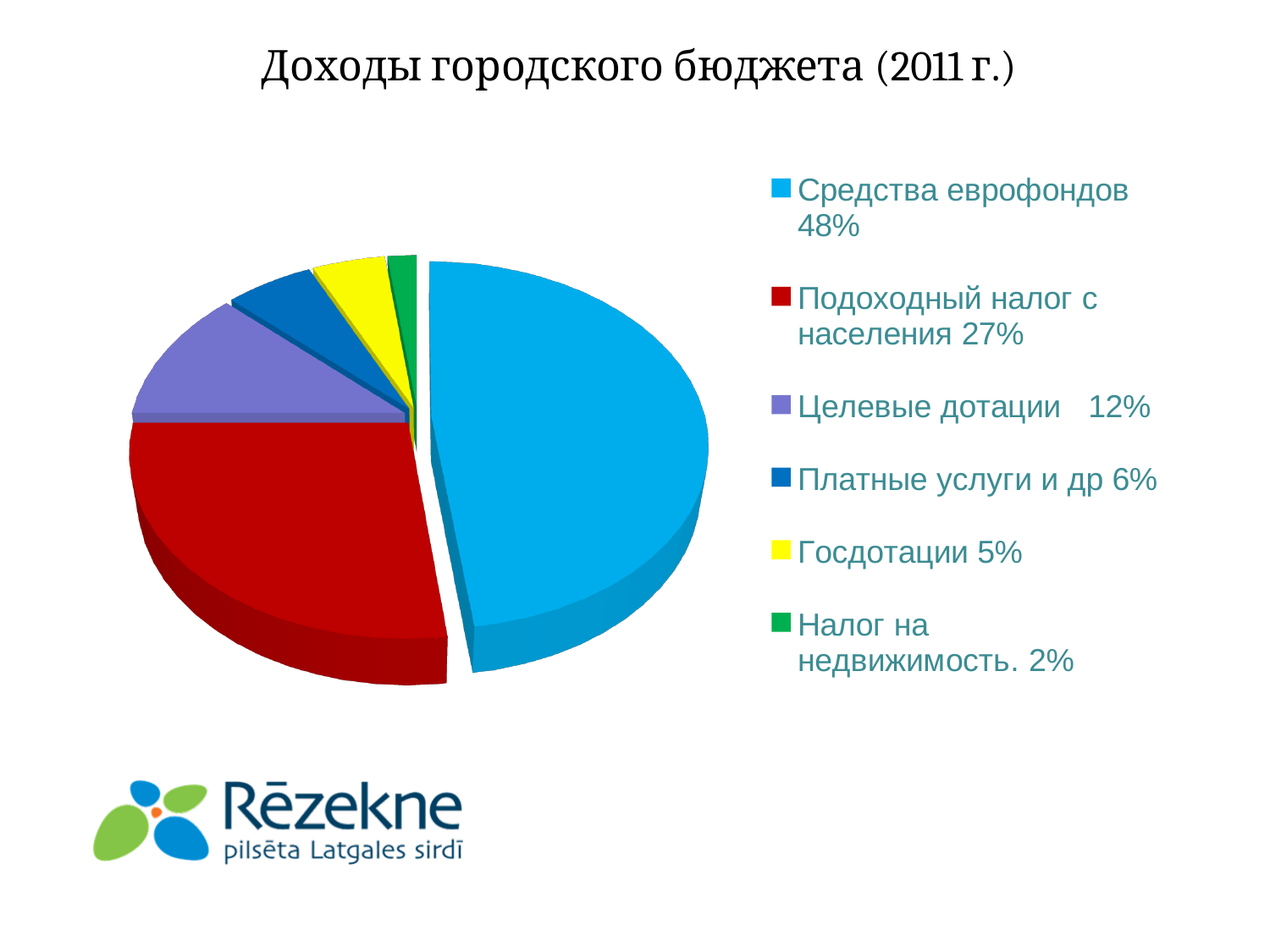
What percentage is shown for Подоходный налог с населения? 27% What kind of chart is shown on the slide? pie chart What is the difference in percentage points between Средства еврофондов and Подоходный налог с населения? 21 Which is larger: Платные услуги и др or Госдотации? Платные услуги и др What is the title of the chart? Доходы городского бюджета (2011 г.) How many categories does the pie chart have? 6 What percentage is shown for Госдотации? 5% What percentage is shown for Целевые дотации? 12% What colour is the slice for Подоходный налог с населения? red Which category has the largest share of the pie? Средства еврофондов Which category has the smallest share of the pie? Налог на недвижимость What share of the city budget income comes from Средства еврофондов? 48%